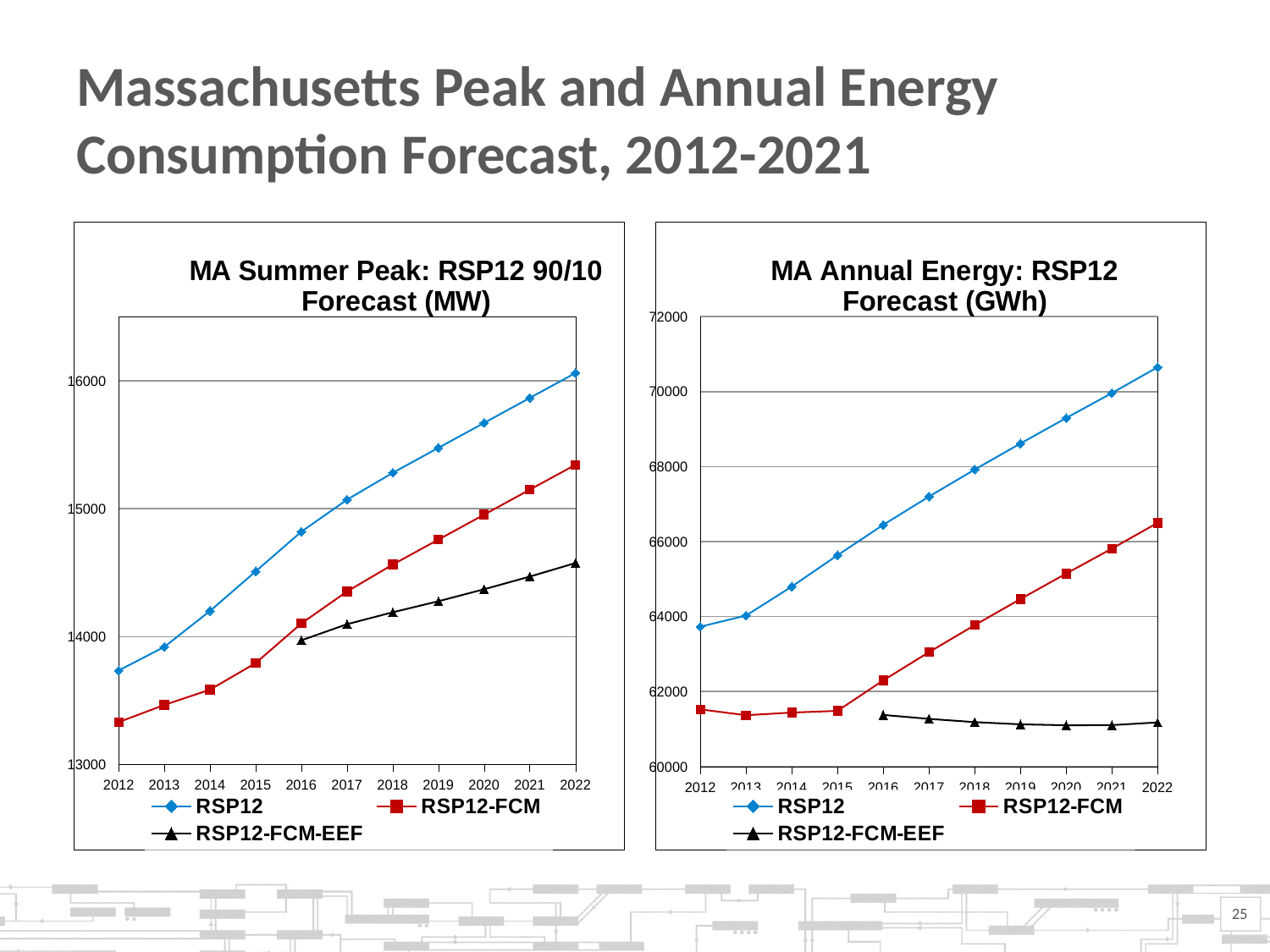
In the MA Annual Energy chart, is the RSP12-FCM-EEF value for 2022 greater or less than 62000? less In the MA Summer Peak chart, is the RSP12-FCM value for 2012 greater or less than 14000? less What kind of chart is the MA Summer Peak chart on the left? line chart In the MA Annual Energy chart, does the RSP12 series rise or fall from 2012 to 2022? rise In the MA Summer Peak chart, is the RSP12-FCM-EEF value for 2022 greater or less than 15000? less In the MA Annual Energy chart, which is larger in 2020: RSP12 or RSP12-FCM? RSP12 In the MA Annual Energy chart, which series has the lowest value in 2022? RSP12-FCM-EEF In the MA Summer Peak chart, which series has the highest value in 2022? RSP12 In the MA Summer Peak chart, how many years are shown on the x axis? 11 How many series does the legend of the MA Annual Energy chart on the right list? 3